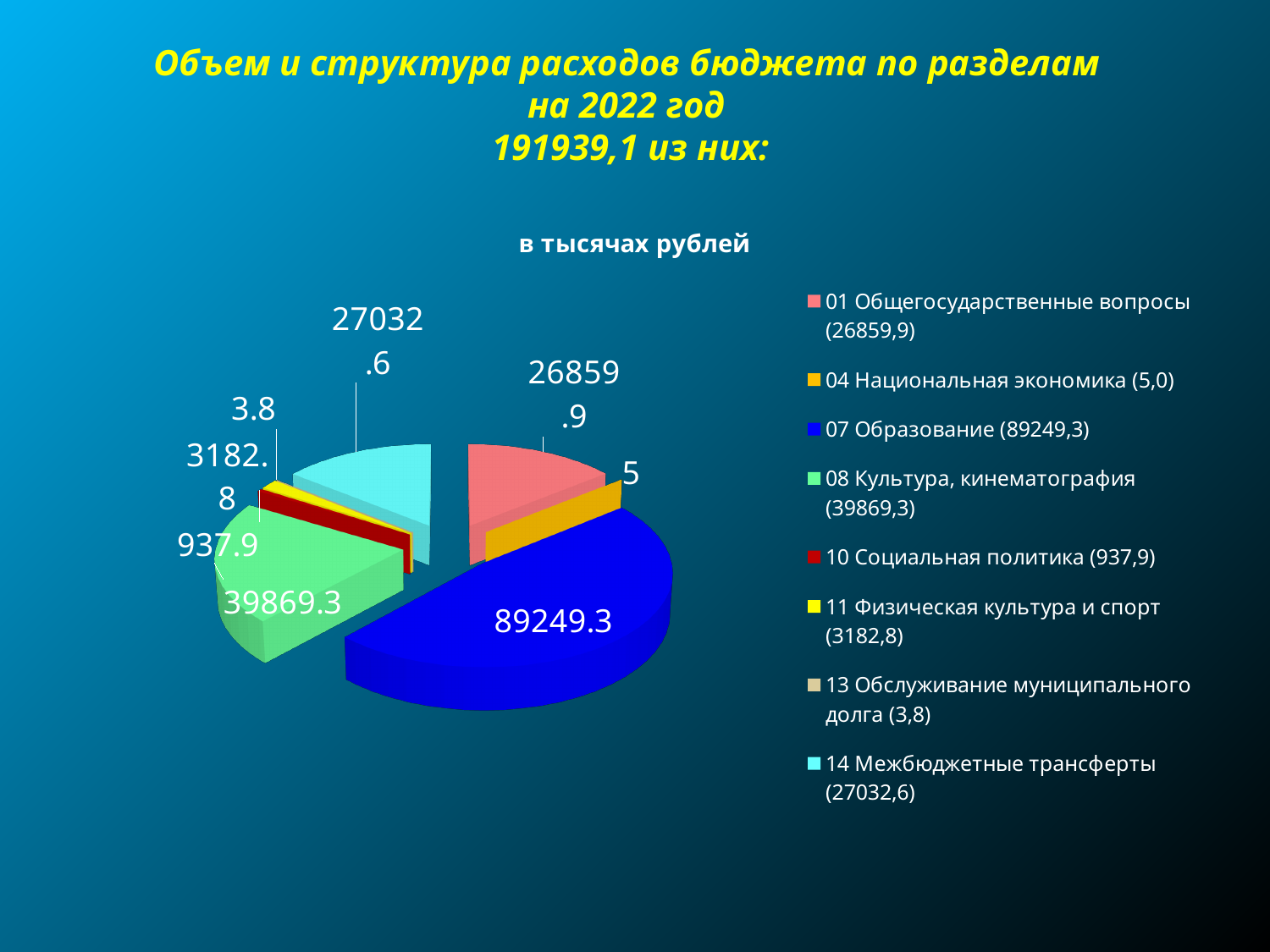
Which is larger: 14 Межбюджетные трансферты or 01 Общегосударственные вопросы? 14 Межбюджетные трансферты What is the value shown for 08 Культура, кинематография? 39869.3 Which section has the smallest value? 13 Обслуживание муниципального долга What is the value shown for 07 Образование? 89249.3 What kind of chart is shown on the slide? pie chart What is the difference between the values for 07 Образование and 08 Культура, кинематография? 49380 What unit is stated above the chart? в тысячах рублей What is the value shown for 10 Социальная политика? 937.9 Which section has the largest share of the pie? 07 Образование How many slices does the pie chart have? 8 What is the value shown for 11 Физическая культура и спорт? 3182.8 How many entries does the legend list? 8